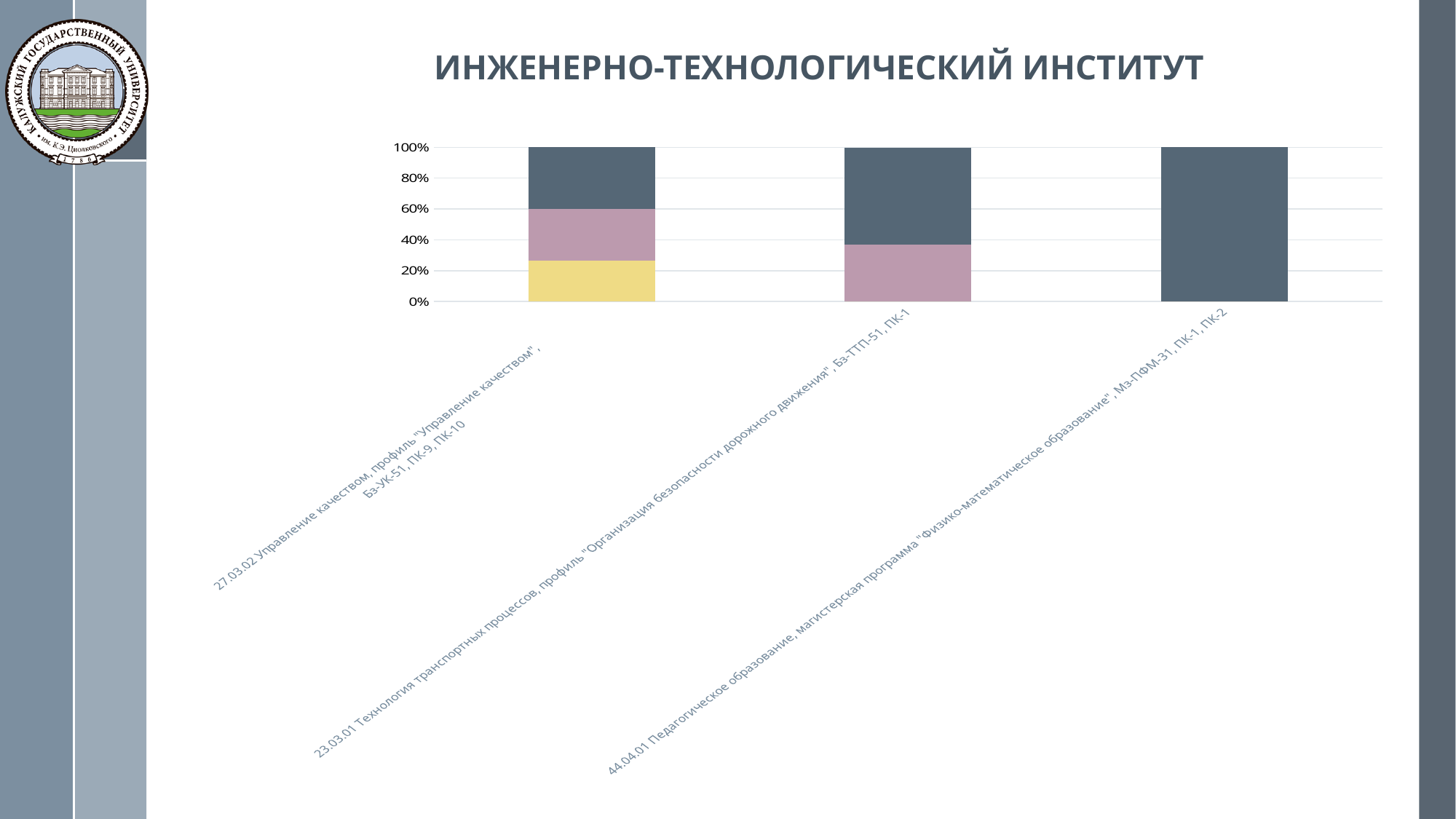
What is the title of the slide above the chart? ИНЖЕНЕРНО-ТЕХНОЛОГИЧЕСКИЙ ИНСТИТУТ How many coloured segments make up the bar for 44.04.01 Педагогическое образование? 1 What is the total height of the stacked bar for 44.04.01 Педагогическое образование? 100% What kind of chart is shown on the slide? Stacked bar chart Is the top of the yellow segment in the bar for 27.03.02 Управление качеством greater or less than 40%? less What is the total height of the stacked bar for 27.03.02 Управление качеством? 100% Is the top of the pink segment in the bar for 23.03.01 Технология транспортных процессов greater or less than 60%? less Is the top of the pink segment in the bar for 23.03.01 Технология транспортных процессов greater or less than 20%? greater How many categories (bars) are shown on the chart? 3 What is the highest value shown on the vertical axis? 100% How many coloured segments make up the bar for 27.03.02 Управление качеством? 3